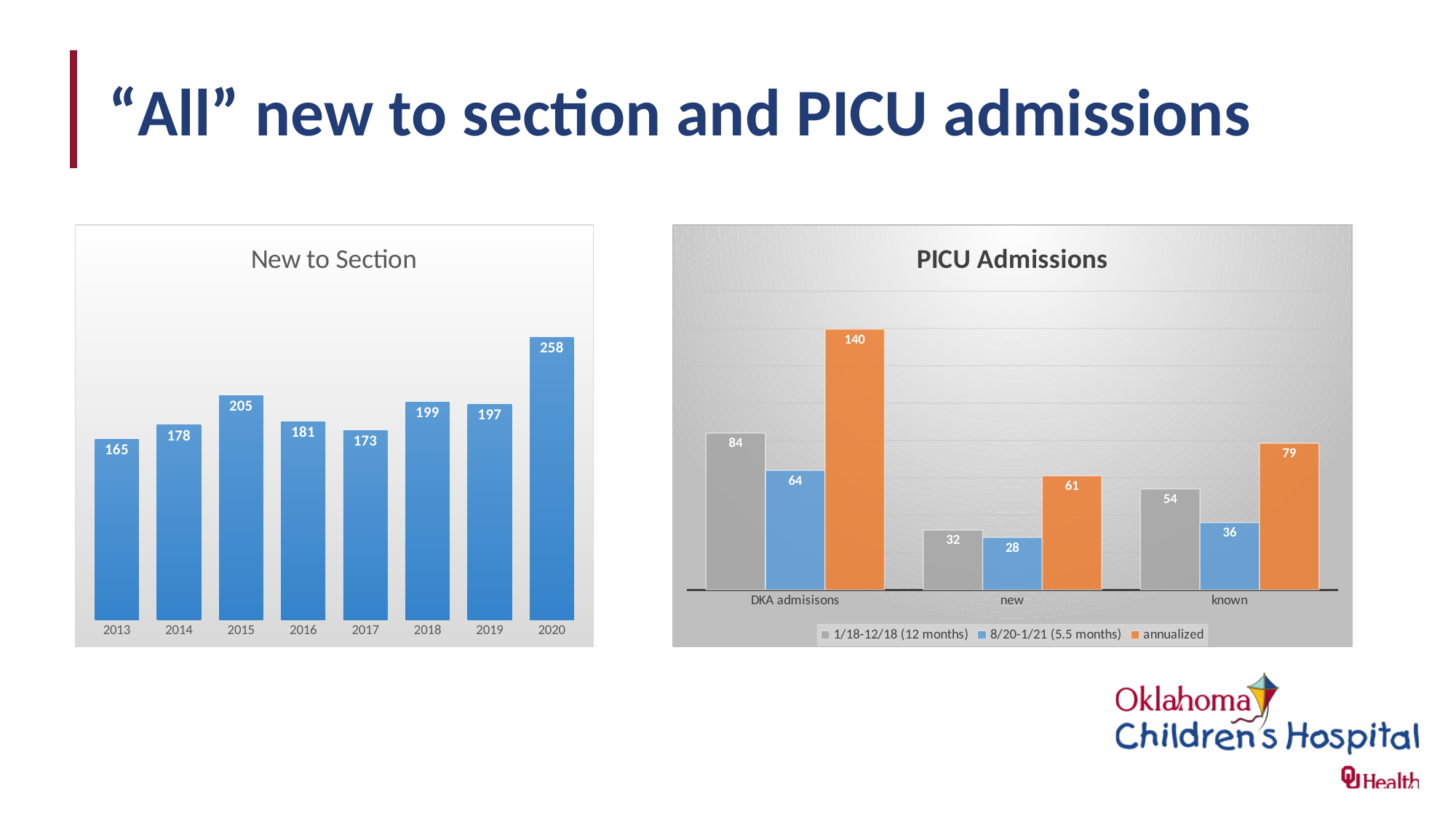
In the 'New to Section' chart, which year has the highest value? 2020 In the 'New to Section' chart, what is the value for 2015? 205 In the 'PICU Admissions' chart, which category has the lowest 1/18-12/18 (12 months) value? new In the 'New to Section' chart, which year has the lowest value? 2013 In the 'PICU Admissions' chart, how many series does the legend list? 3 In the 'New to Section' chart, which is larger, the value for 2016 or the value for 2017? 2016 In the 'PICU Admissions' chart, what is the annualized value for DKA admisisons? 140 What kind of chart is the 'PICU Admissions' chart? Bar chart In the 'PICU Admissions' chart, what is the 8/20-1/21 (5.5 months) value for known? 36 In the 'New to Section' chart, what is the difference between the 2020 and 2019 values? 61 In the 'PICU Admissions' chart, what is the difference between the 1/18-12/18 (12 months) value and the annualized value for new? 29 In the 'New to Section' chart, how many years are shown on the x axis? 8